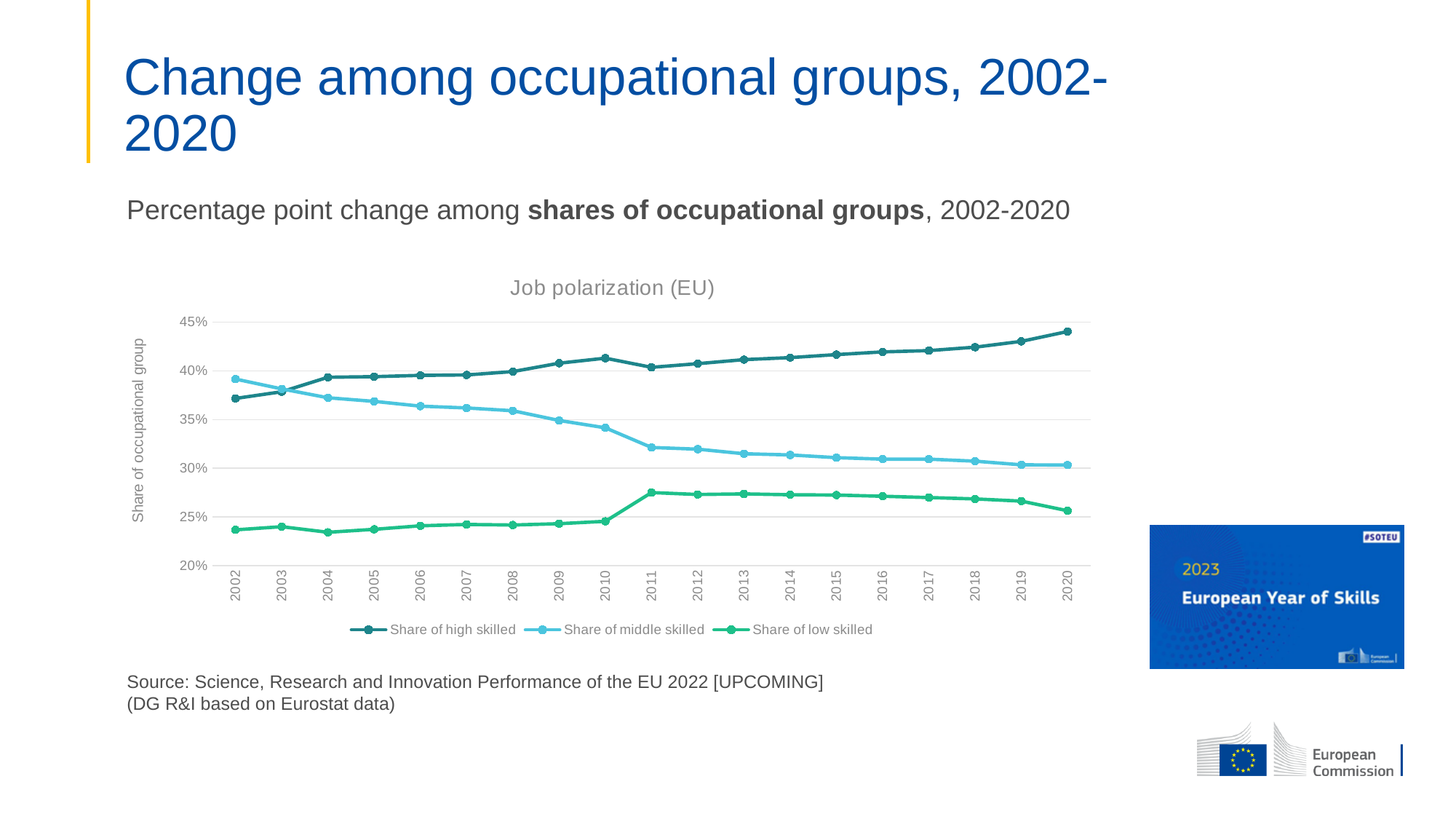
In which year is the share of high skilled at its highest? 2020 Does the share of high skilled rise or fall from 2002 to 2020? Rise How many years are plotted along the x axis of the chart? 19 What kind of chart is shown on the slide? Line chart What is the label on the vertical axis of the chart? Share of occupational group What is the title of the chart? Job polarization (EU) In 2002, which is larger: the share of high skilled or the share of middle skilled? Share of middle skilled How many series does the legend of the chart list? 3 Is the share of low skilled in 2002 greater or less than 25%? less Is the share of middle skilled in 2020 greater or less than 35%? less Does the share of middle skilled rise or fall from 2002 to 2020? Fall Is the share of high skilled in 2020 greater or less than 40%? greater